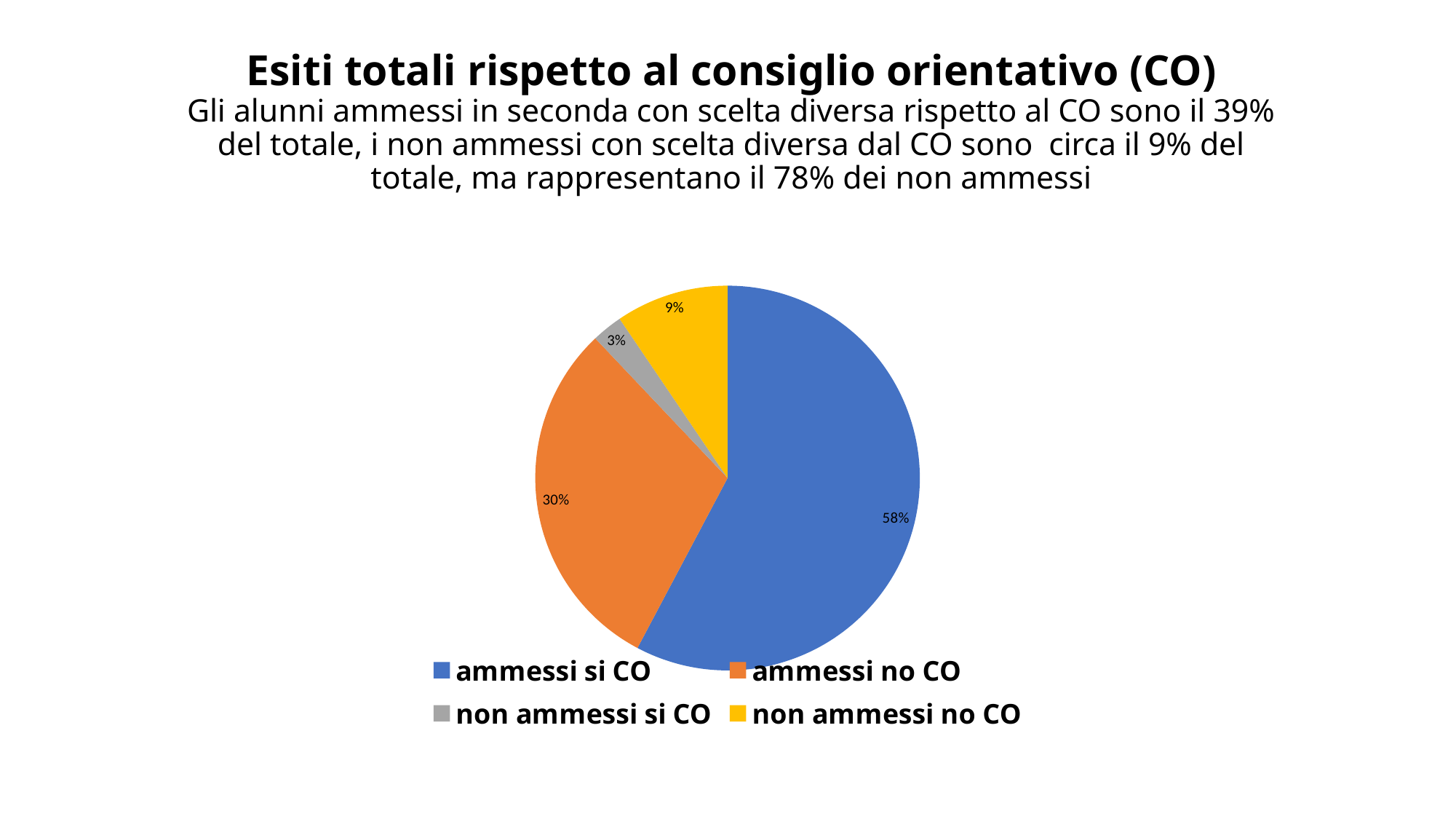
What share of the pie does the 'non ammessi si CO' slice represent? 3% Which slice is larger: 'non ammessi no CO' or 'non ammessi si CO'? non ammessi no CO What kind of chart is shown on the slide? pie chart Which category has the largest slice of the pie? ammessi si CO What is the difference in percentage points between the 'ammessi si CO' and 'ammessi no CO' slices? 28 Which category has the smallest slice of the pie? non ammessi si CO What colour is the 'ammessi no CO' slice? orange What share of the pie does the 'ammessi si CO' slice represent? 58% What share of the pie does the 'ammessi no CO' slice represent? 30% How many slices does the pie chart have? 4 How many entries does the legend list? 4